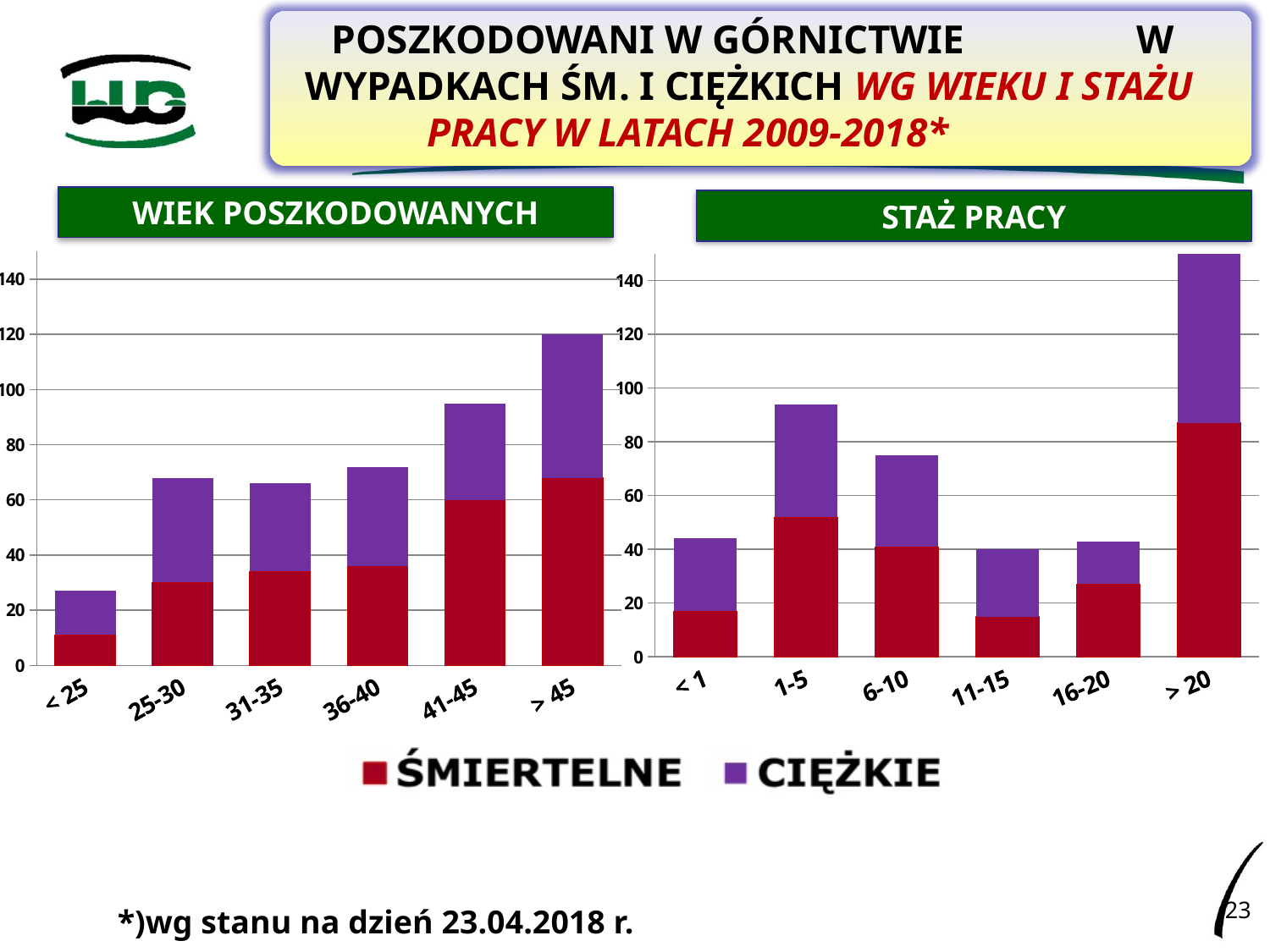
In the WIEK POSZKODOWANYCH chart, is the total for < 25 greater or less than 40? less What kind of chart is the WIEK POSZKODOWANYCH chart? stacked bar chart How many series does the legend list for the charts? 2 In the STAŻ PRACY chart, which category has the highest total bar? > 20 In the WIEK POSZKODOWANYCH chart, is the total for > 45 greater or less than 100? greater In the STAŻ PRACY chart, is the total for 1-5 greater or less than 80? greater How many categories are shown on the x axis of the STAŻ PRACY chart? 6 In the WIEK POSZKODOWANYCH chart, which age category has the highest total bar? > 45 In the STAŻ PRACY chart, which has the larger total bar, 6-10 or 16-20? 6-10 In the WIEK POSZKODOWANYCH chart, which age category has the lowest total bar? < 25 In the WIEK POSZKODOWANYCH chart, which has the larger total bar, 41-45 or 36-40? 41-45